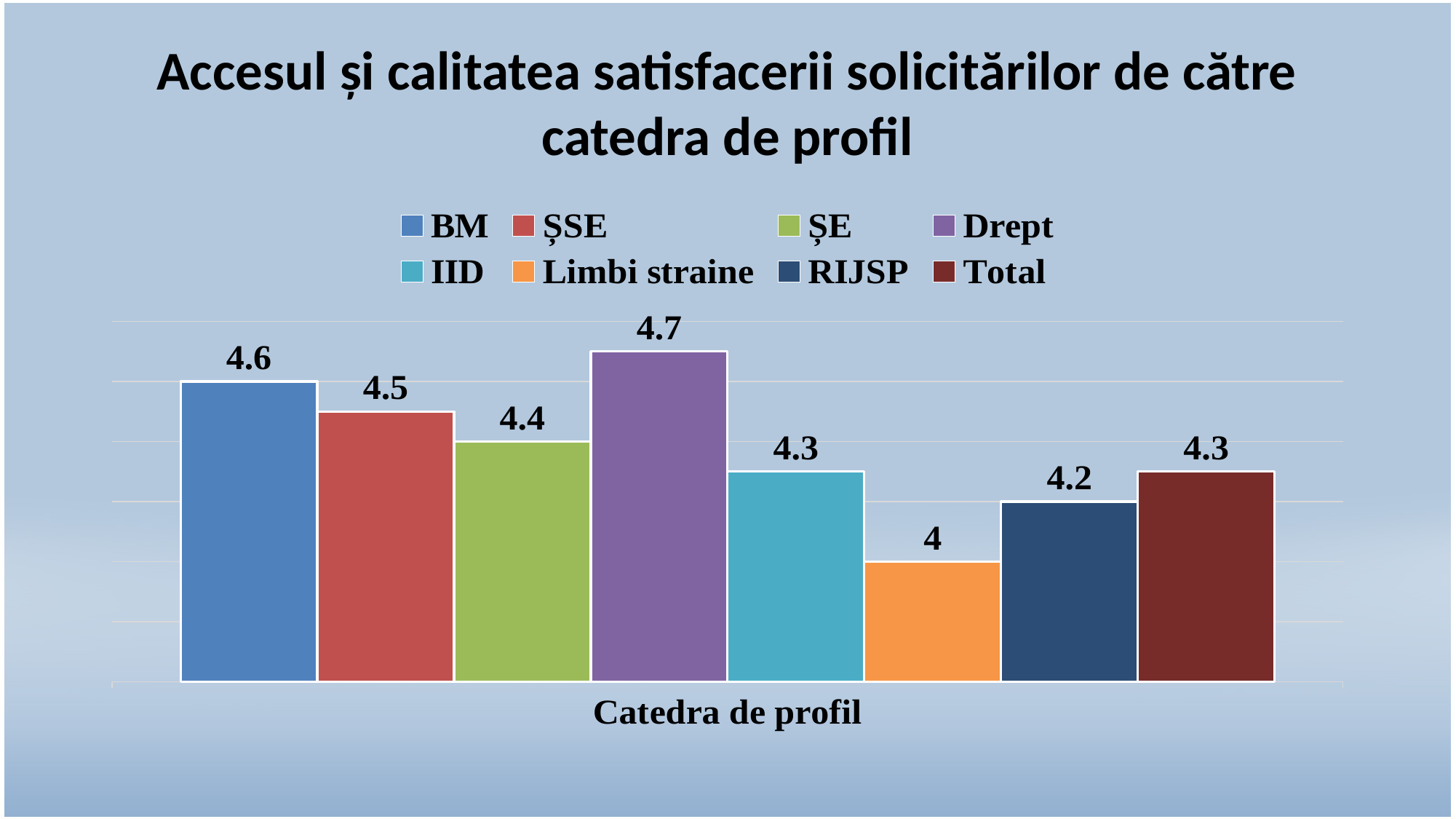
What is the difference between the values for Drept and Limbi straine? 0.7 What is the label on the horizontal axis? Catedra de profil What kind of chart is shown on the slide? Bar chart What is the value for Drept? 4.7 Which is larger, the value for ȘE or the value for IID? ȘE What is the value for RIJSP? 4.2 What is the value for Total? 4.3 What is the difference between the values for BM and ȘSE? 0.1 What is the value for Limbi straine? 4 Which series has the highest value? Drept How many series does the legend list? 8 Which series has the lowest value? Limbi straine